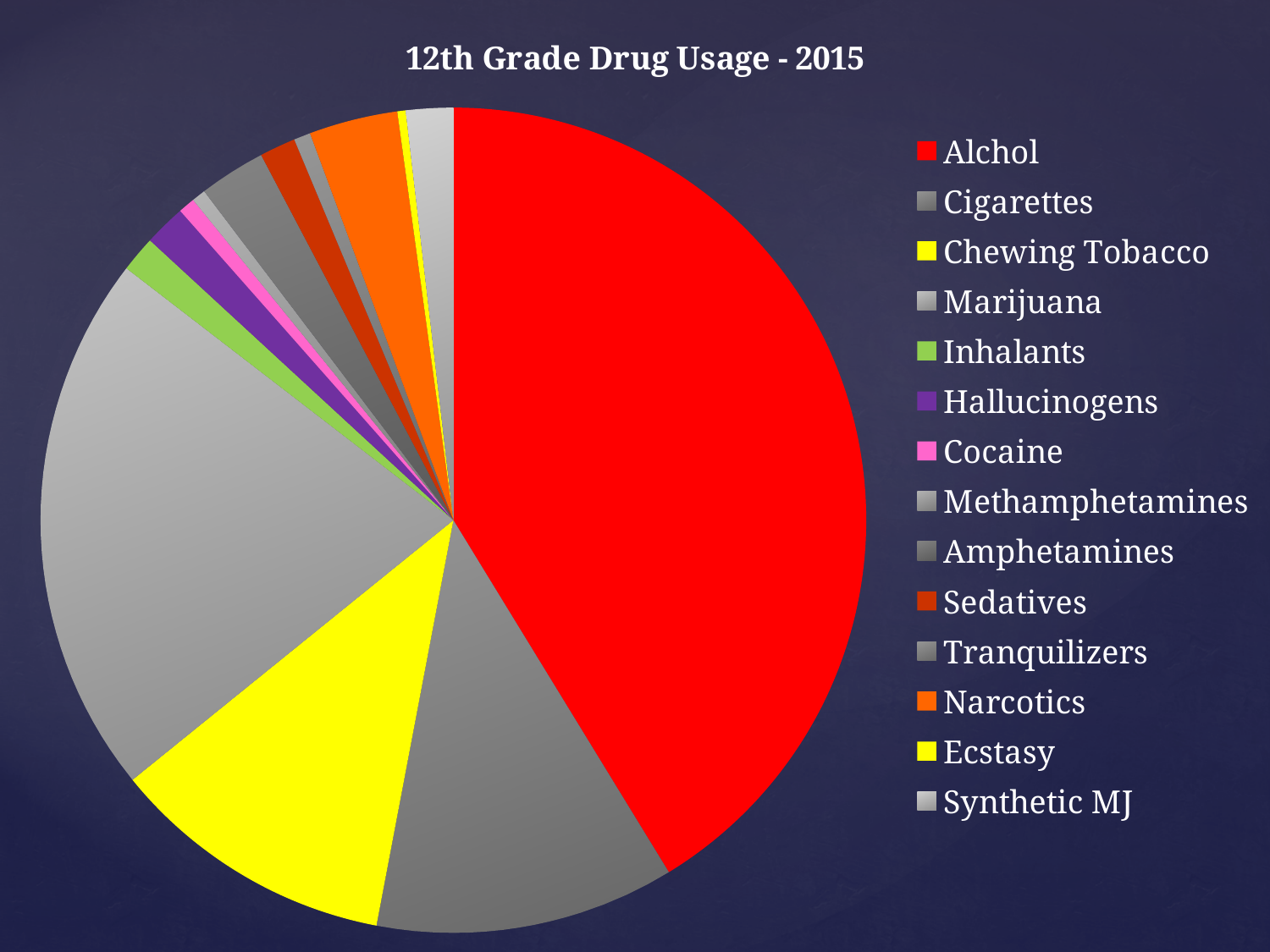
Does the Alchol slice make up more or less than half of the pie? less than half Which is larger, the slice for Alchol or the slice for Marijuana? Alchol What kind of chart is shown on the slide? pie chart Which is larger, the slice for Chewing Tobacco or the slice for Inhalants? Chewing Tobacco Which category has the largest slice of the pie? Alchol How many categories does the pie chart have? 14 Which is larger, the slice for Cigarettes or the slice for Hallucinogens? Cigarettes What is the title of the chart? 12th Grade Drug Usage - 2015 What colour is the slice for Alchol? red